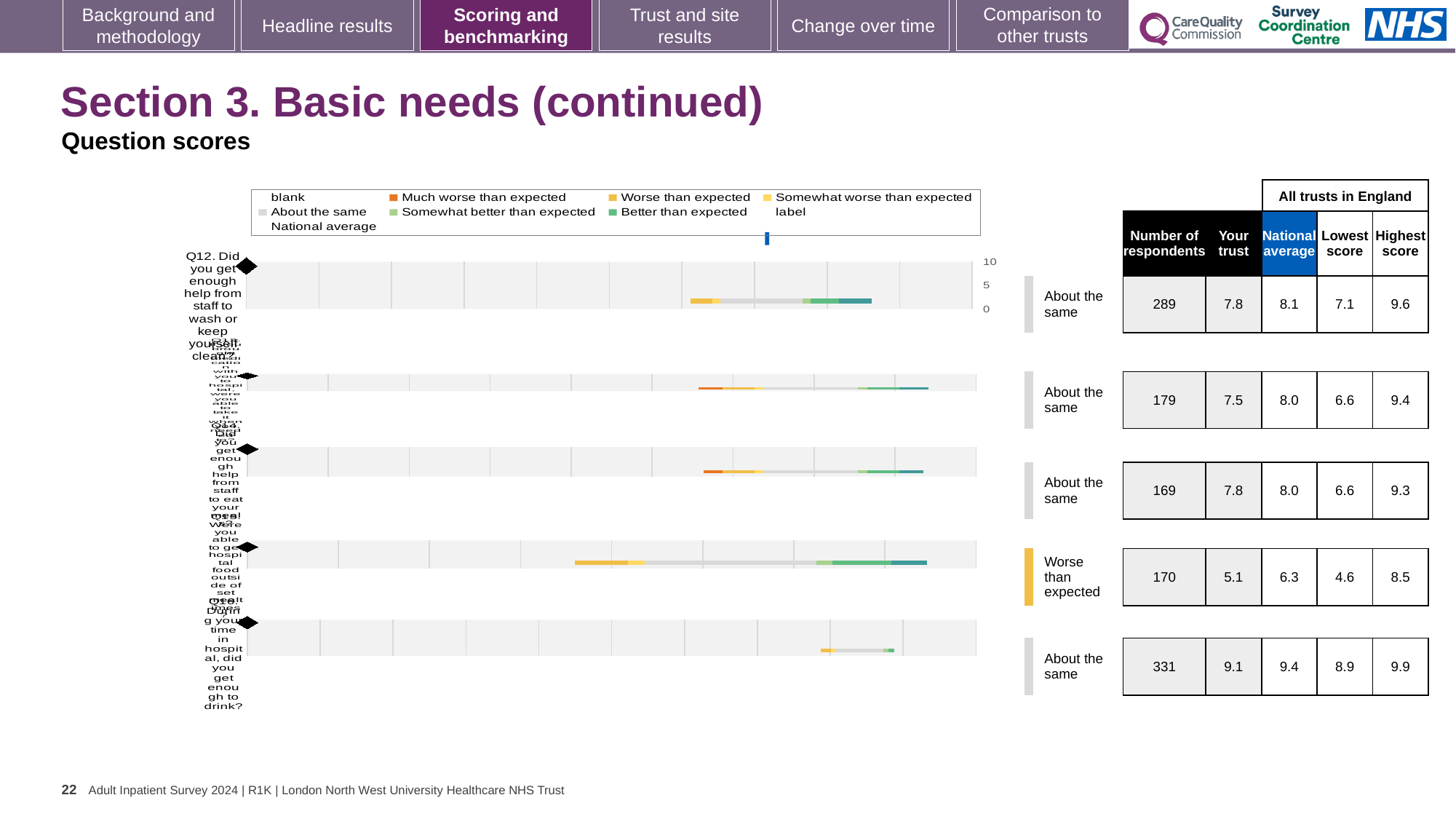
In the table beside the chart, what is the 'Your trust' score for the first row (Q12)? 7.8 In the table beside the chart, what is the 'Your trust' score for the fourth row (the one rated 'Worse than expected')? 5.1 Which row has the lowest 'Your trust' score in the table beside the chart? the fourth row (rated 'Worse than expected'), 5.1 In the table beside the chart, what is the highest score for the last row (Q16, enough to drink)? 9.9 In the table beside the chart, what is the national average for the fourth row (the one rated 'Worse than expected')? 6.3 How many question rows (bars) does the chart show? 5 Which row has the highest 'Your trust' score in the table beside the chart? the last row (Q16, enough to drink), 9.1 What kind of chart is shown on the slide? bar chart Is the 'Your trust' score for the first row (Q12) larger or smaller than the national average for that row? smaller How many of the five rows are rated 'Worse than expected' rather than 'About the same'? 1 In the table beside the chart, what is the number of respondents for the first row (Q12, help from staff to wash or keep yourself clean)? 289 For the fourth row (rated 'Worse than expected'), what is the difference between the national average and the 'Your trust' score? 1.2